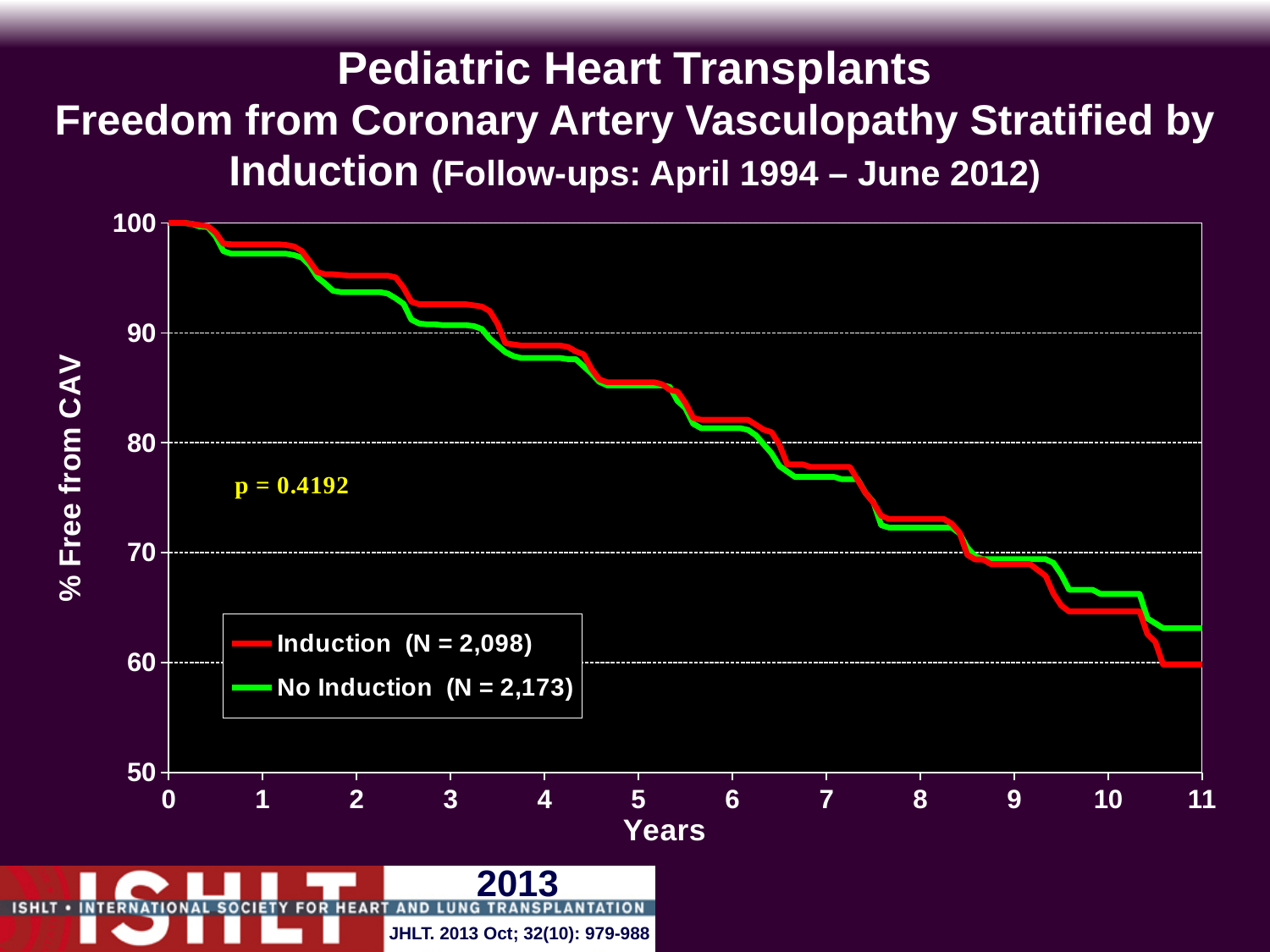
What is the label of the y axis? % Free from CAV Is the value for the No Induction group at 11 years greater or less than 60? greater What is the N for the Induction group shown in the legend? 2,098 What is the N for the No Induction group shown in the legend? 2,173 Is the value for the Induction group at 5 years greater or less than 80? greater At 11 years, which group has the higher % free from CAV, Induction or No Induction? No Induction Is the value for the Induction group at 10 years greater or less than 70? less Do the curves rise or fall as years increase along the x axis? Fall What kind of chart is shown on the slide? Line chart What are the two series named in the legend? Induction (N = 2,098) and No Induction (N = 2,173) What p-value is printed on the chart? p = 0.4192 How many series does the legend list? 2